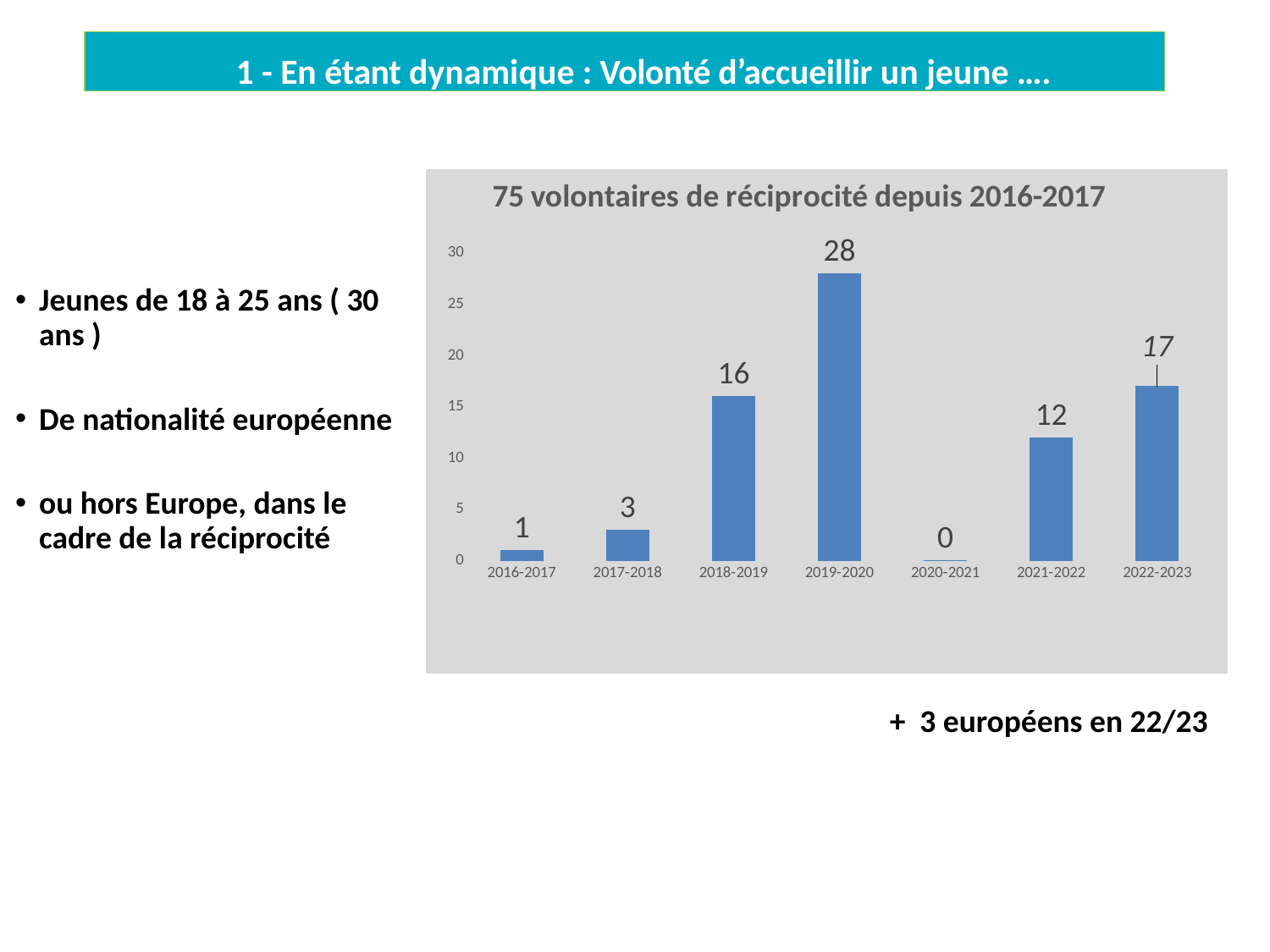
What is the value for 2020-2021? 0 How many categories are shown on the x axis? 7 What is the value for 2022-2023? 17 Which category has the highest value? 2019-2020 Which is larger, the value for 2021-2022 or the value for 2022-2023? 2022-2023 What is the title of the chart? 75 volontaires de réciprocité depuis 2016-2017 Do the values rise or fall from 2016-2017 to 2019-2020? rise What kind of chart is shown? bar chart What is the difference between the values for 2019-2020 and 2018-2019? 12 What is the value for 2019-2020? 28 Which category has the lowest value? 2020-2021 Is the value for 2018-2019 greater or less than 10? greater